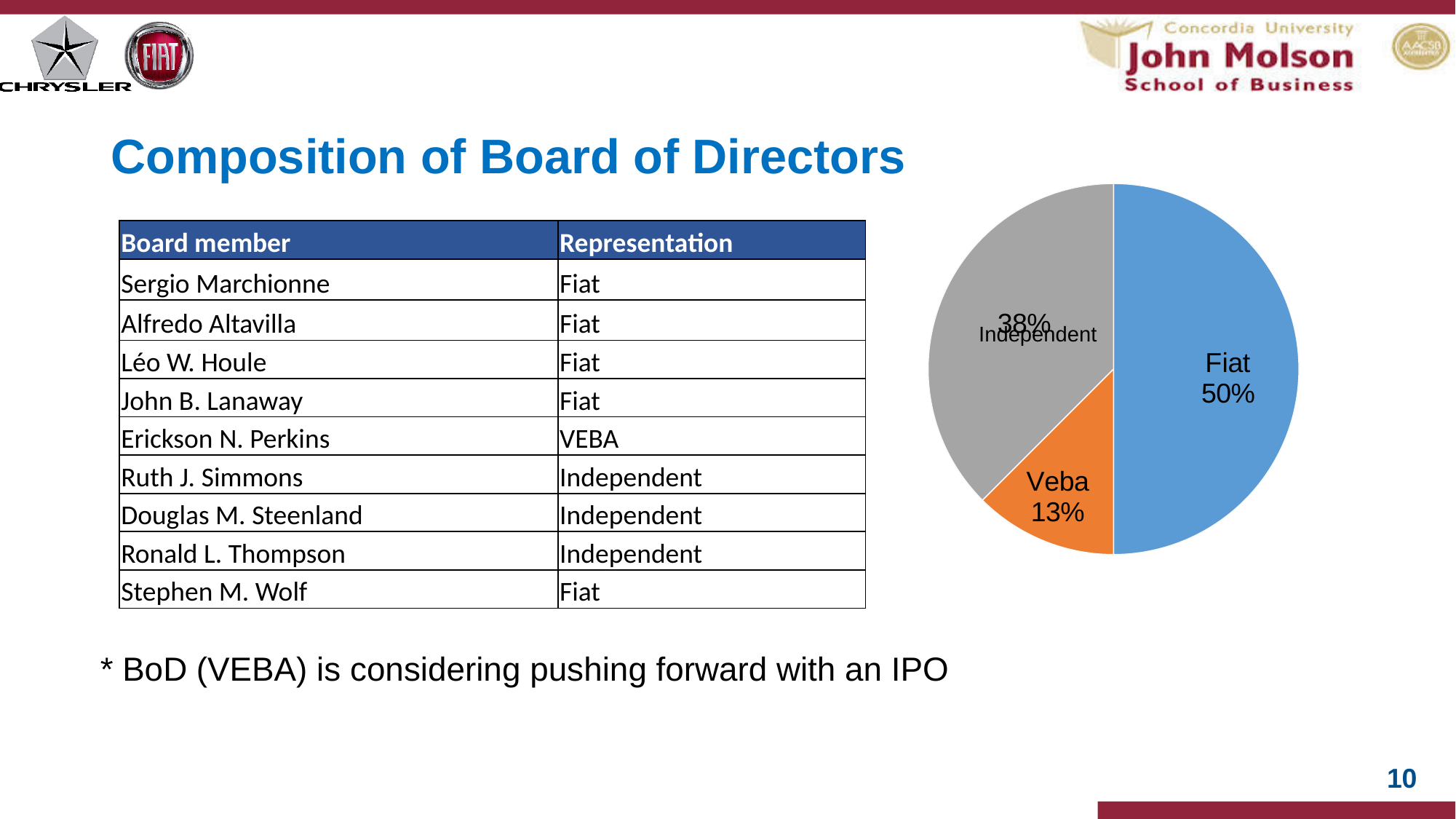
What colour is the Fiat slice in the pie chart? blue Which is larger in the pie chart, Independent or Veba? Independent What colour is the Veba slice in the pie chart? orange How many slices does the pie chart have? 3 What share of the pie does Veba hold? 13% What is the difference in percentage points between the Fiat slice and the Independent slice? 12 What is the difference in percentage points between the Fiat slice and the Veba slice? 37 Which slice of the pie chart is the largest? Fiat Which slice of the pie chart is the smallest? Veba What kind of chart is shown on the slide? pie chart What share of the pie does Independent hold? 38% What share of the pie does Fiat hold? 50%